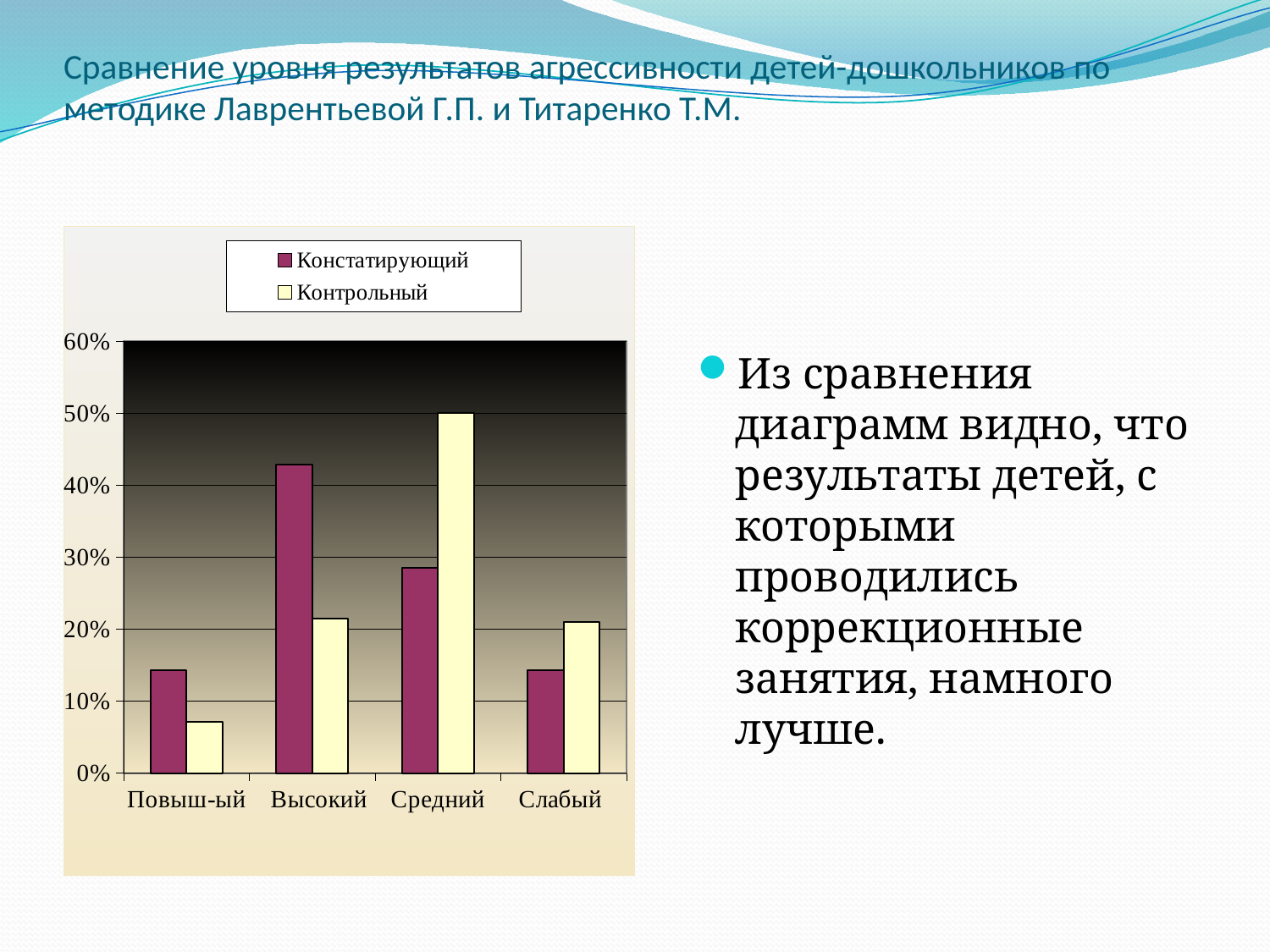
Is the Констатирующий value for Средний greater or less than 30%? less Which category has the lowest value for the Контрольный series? Повыш-ый Which series is shown in yellow in the chart legend? Контрольный Is the Констатирующий value for Высокий greater or less than 40%? greater Is the Контрольный value for Повыш-ый greater or less than 10%? less How many categories are shown on the x axis of the chart? 4 For the Средний category, which series has the larger value, Констатирующий or Контрольный? Контрольный Which category has the highest value for the Контрольный series? Средний Which category has the highest value for the Констатирующий series? Высокий How many series does the chart legend list? 2 What kind of chart is shown on the slide? bar chart For the Высокий category, which series has the larger value, Констатирующий or Контрольный? Констатирующий